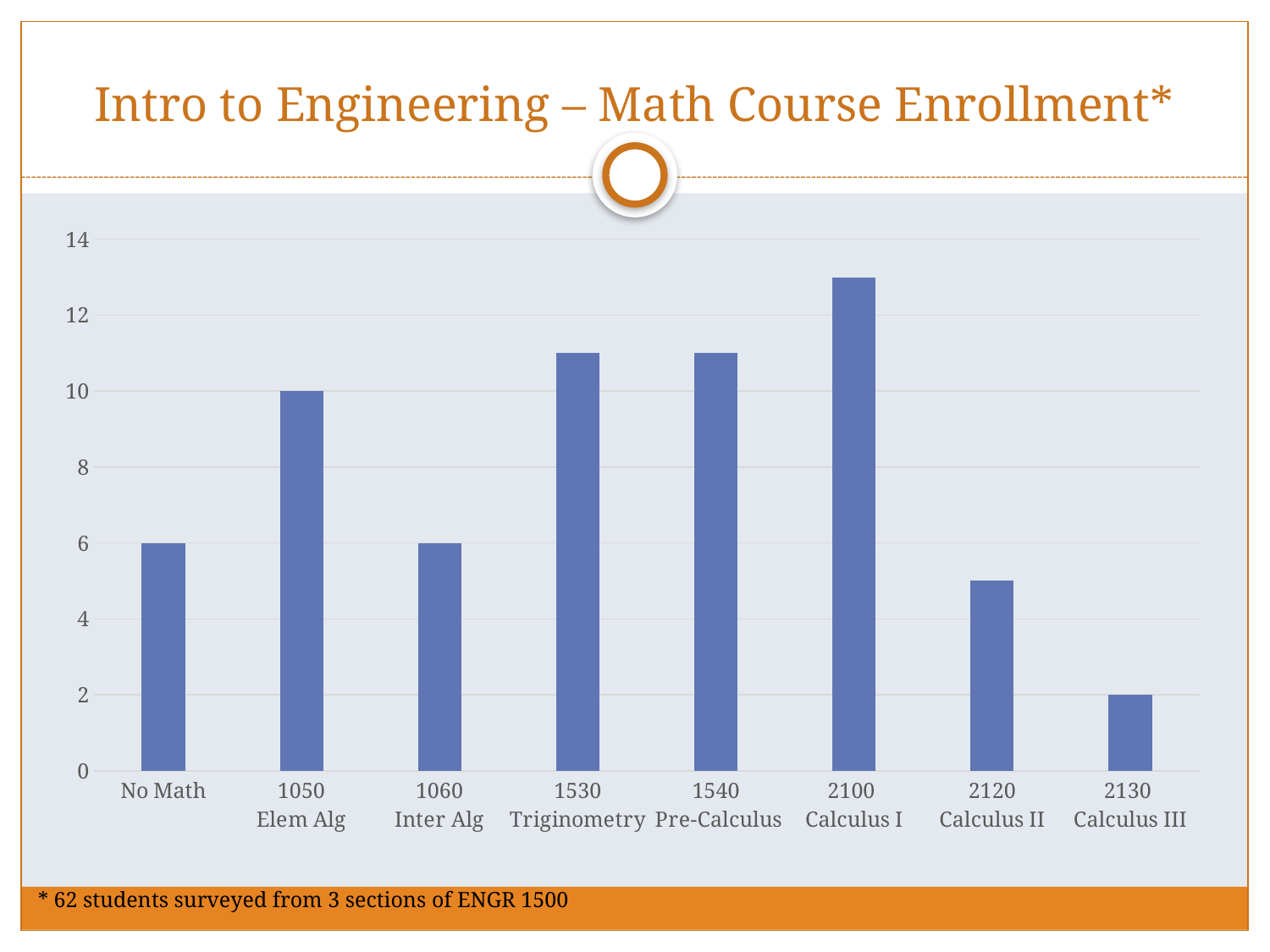
Which category has the lowest value? 2130 Calculus III What is the value for 1050 Elem Alg? 10 What is the difference between the values for 1050 Elem Alg and 1060 Inter Alg? 4 How many categories are shown on the x axis of the chart? 8 What is the value for No Math? 6 Is the value for 2120 Calculus II greater or less than 6? less Which is larger, the value for 2100 Calculus I or the value for 1050 Elem Alg? 2100 Calculus I Which category has the highest value? 2100 Calculus I What is the title of the slide containing the chart? Intro to Engineering – Math Course Enrollment* Is the value for 2100 Calculus I greater or less than 12? greater What type of chart is shown on the slide? bar chart What is the value for 2130 Calculus III? 2